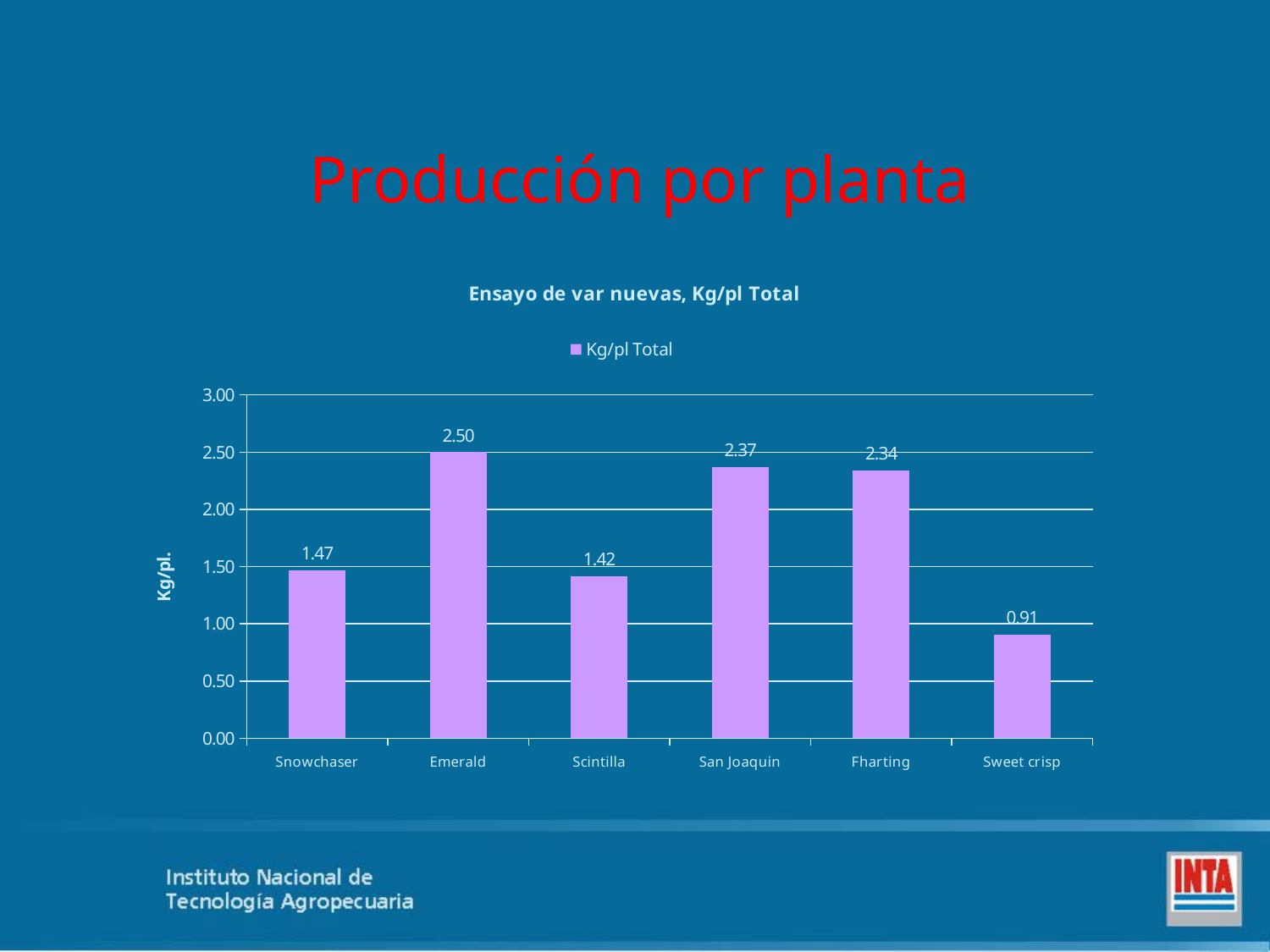
Which has a higher Kg/pl Total, Snowchaser or Fharting? Fharting Which variety has the lowest Kg/pl Total? Sweet crisp What is the title of the chart? Ensayo de var nuevas, Kg/pl Total Is the value for Scintilla greater or less than 1.50? less Which variety has the highest Kg/pl Total? Emerald What is the Kg/pl Total value for Sweet crisp? 0.91 What is the difference in Kg/pl Total between Snowchaser and Scintilla? 0.05 What is the Kg/pl Total value for Emerald? 2.50 What is the difference in Kg/pl Total between Emerald and Sweet crisp? 1.59 What is the Kg/pl Total value for San Joaquin? 2.37 What type of chart is shown on the slide? Bar chart How many varieties are shown on the chart? 6